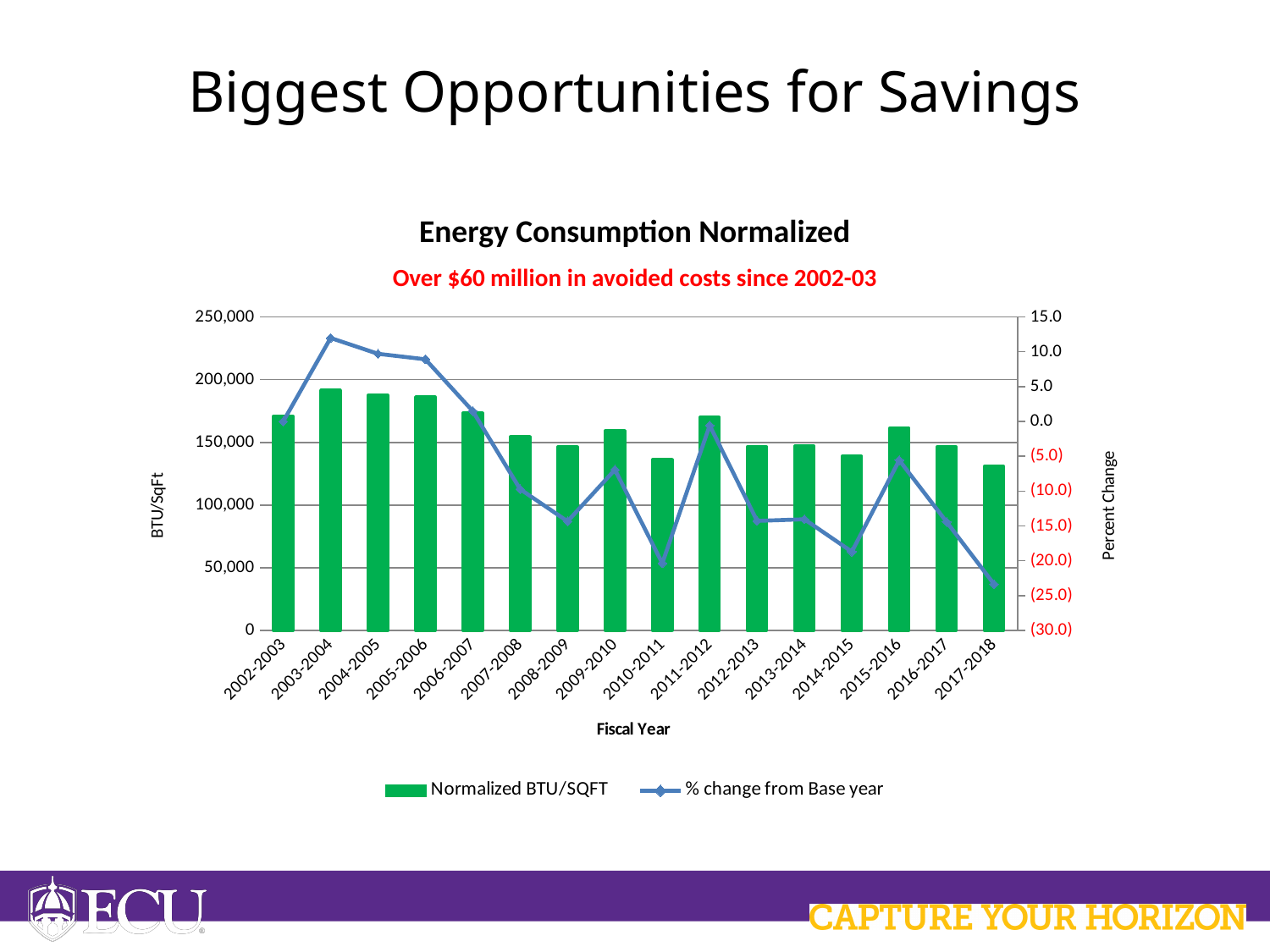
What is the title of the chart? Energy Consumption Normalized What type of chart is shown on the slide? Combined bar and line chart Is the % change from Base year for 2017-2018 greater or less than (20.0)? less In which fiscal year does the % change from Base year line reach its highest point? 2003-2004 Is the Normalized BTU/SQFT value for 2003-2004 greater or less than 150,000? greater Which fiscal year has the highest Normalized BTU/SQFT bar? 2003-2004 Which has the larger Normalized BTU/SQFT bar, 2010-2011 or 2011-2012? 2011-2012 In which fiscal year does the % change from Base year line reach its lowest point? 2017-2018 Which fiscal year has the lowest Normalized BTU/SQFT bar? 2017-2018 How many fiscal years are shown on the x axis of the chart? 16 How many series does the chart legend list? 2 Is the Normalized BTU/SQFT value for 2017-2018 greater or less than 150,000? less